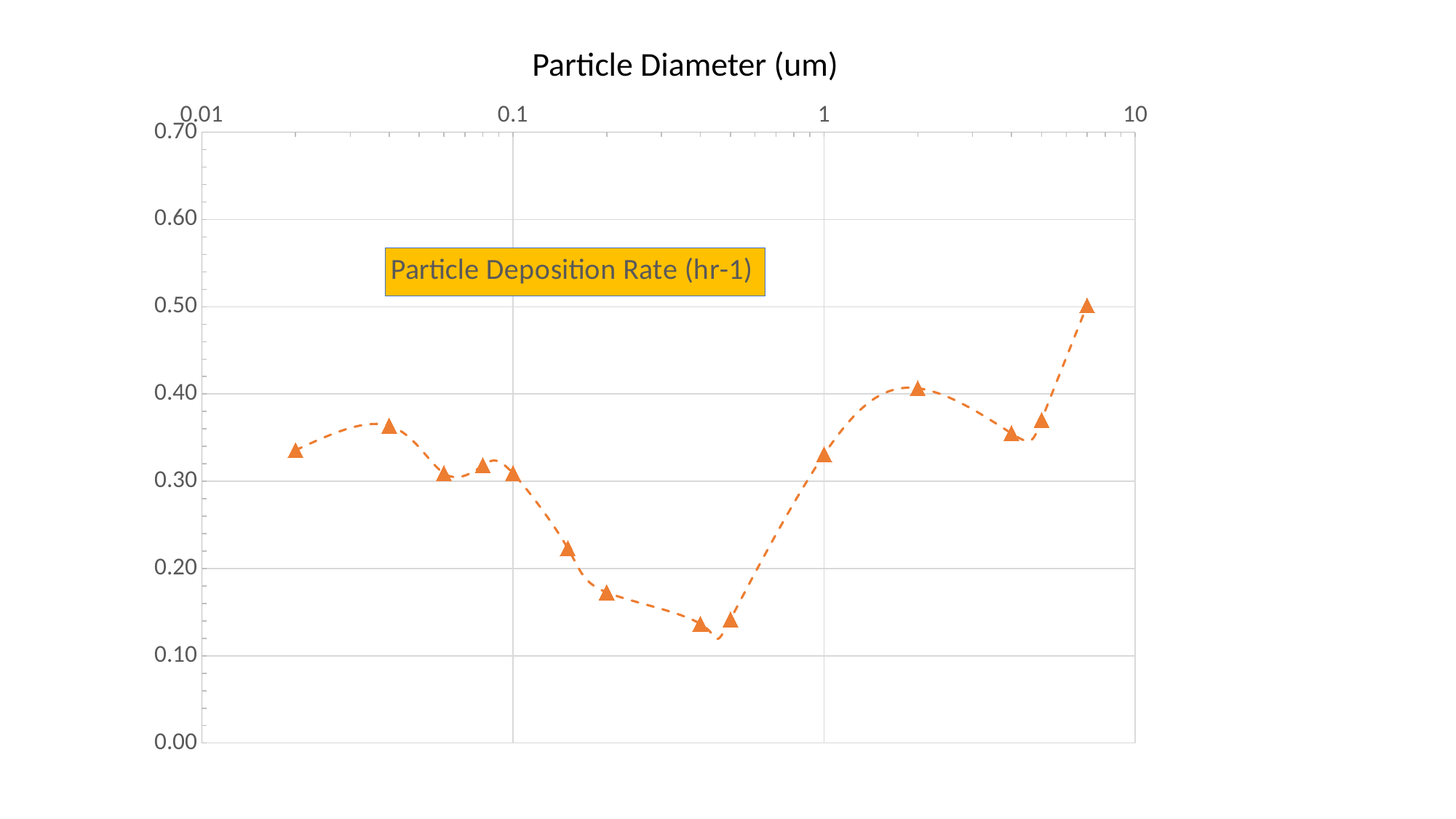
What is the label of the x axis? Particle Diameter (um) Which is larger, the value at 1 um or the value at 0.1 um? 1 um Do the values rise or fall as particle diameter increases from 0.1 um to 0.4 um? fall How many data points are plotted on the chart? 14 Do the values rise or fall as particle diameter increases from 0.5 um to 2 um? rise What kind of chart is shown on the slide? line chart What is the title of the chart? Particle Deposition Rate (hr-1) Is the value at a particle diameter of 1 um greater or less than 0.40? less Is the lowest point on the chart greater or less than 0.20? less Is the value at a particle diameter of 0.1 um greater or less than 0.40? less